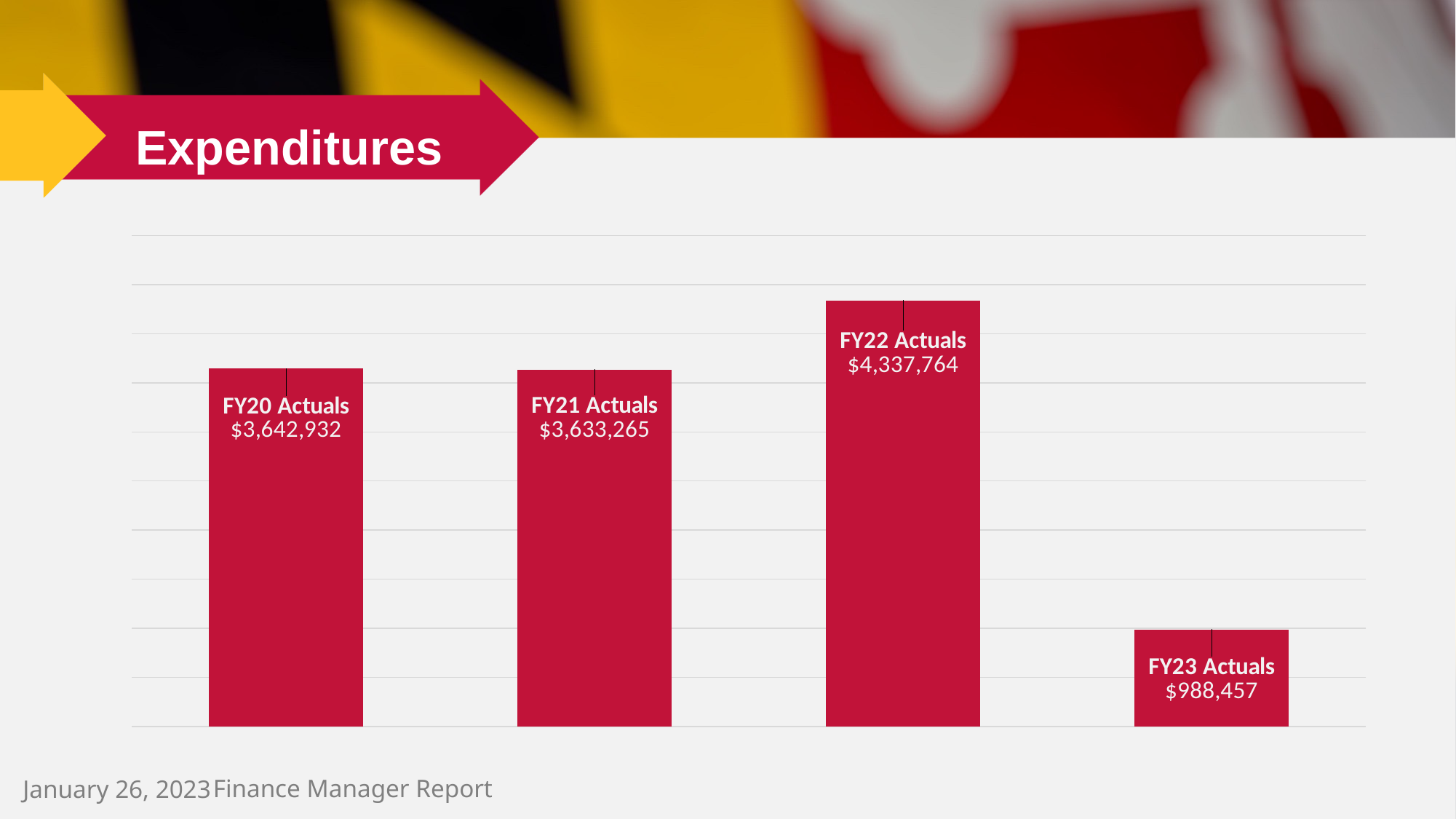
What is the difference between FY22 Actuals and FY20 Actuals? $694,832 Which is larger, FY20 Actuals or FY21 Actuals? FY20 Actuals What is the value for FY22 Actuals? $4,337,764 How many bars are shown in the chart? 4 What kind of chart is shown on the slide? Bar chart Do the values rise or fall from FY22 Actuals to FY23 Actuals? Fall Which fiscal year has the lowest expenditures? FY23 Actuals What is the value for FY23 Actuals? $988,457 Which fiscal year has the highest expenditures? FY22 Actuals What is the value for FY21 Actuals? $3,633,265 What is the value for FY20 Actuals? $3,642,932 What is the difference between FY22 Actuals and FY23 Actuals? $3,349,307